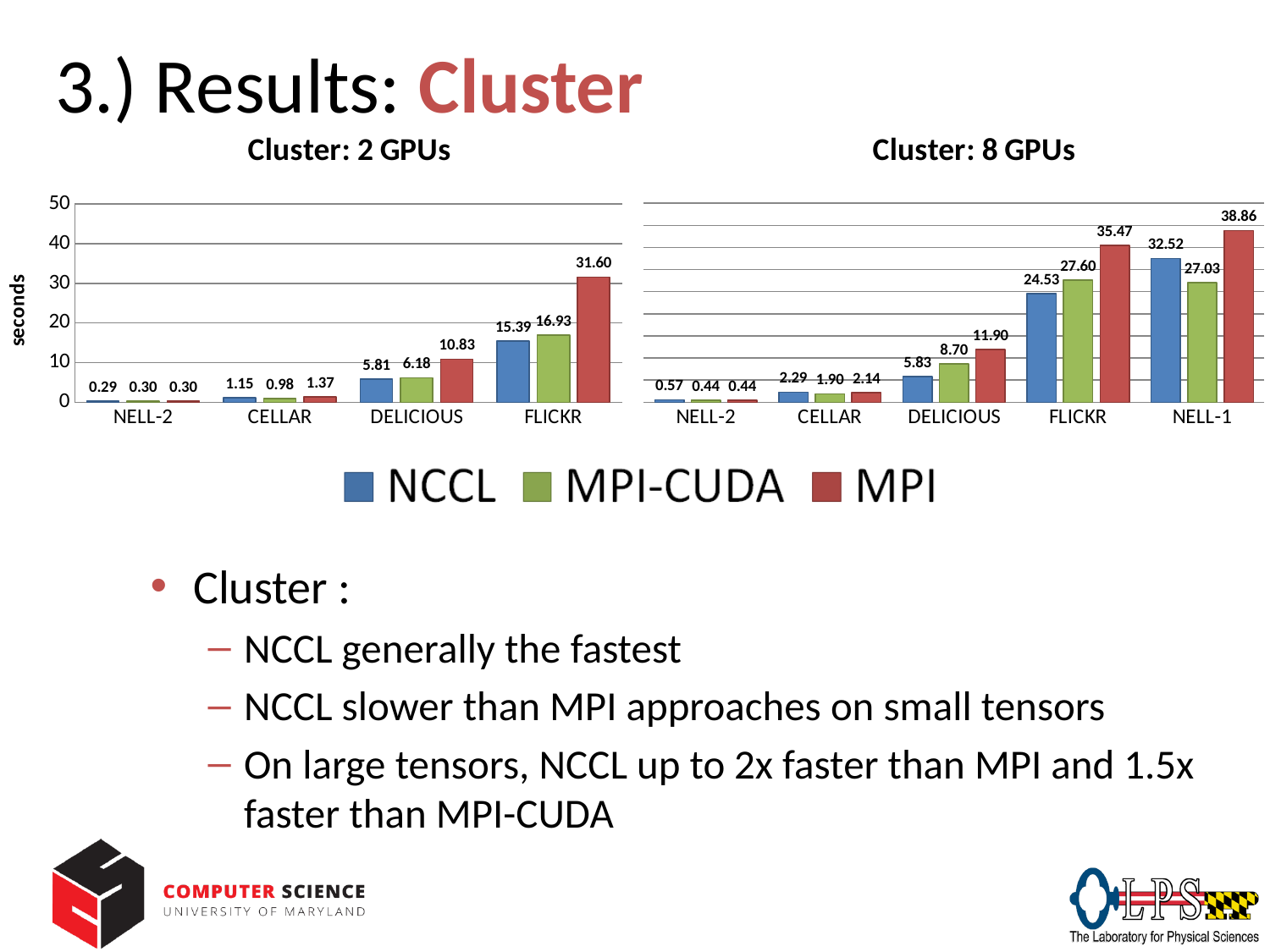
In the 'Cluster: 8 GPUs' chart, which category has the lowest NCCL value? NELL-2 In the 'Cluster: 2 GPUs' chart, what is the difference between the MPI and NCCL values for FLICKR? 16.21 In the 'Cluster: 8 GPUs' chart, what is the MPI-CUDA value for DELICIOUS? 8.70 In the 'Cluster: 2 GPUs' chart, what is the MPI value for FLICKR? 31.60 In the 'Cluster: 8 GPUs' chart, what is the difference between the MPI and MPI-CUDA values for NELL-1? 11.83 In the 'Cluster: 8 GPUs' chart, what is the NCCL value for NELL-1? 32.52 In the 'Cluster: 2 GPUs' chart, which category has the highest MPI value? FLICKR How many series does the legend list? 3 How many categories are shown on the x axis of the 'Cluster: 8 GPUs' chart? 5 What kind of chart is the 'Cluster: 2 GPUs' chart? Bar chart What is the label on the y axis of the 'Cluster: 2 GPUs' chart? seconds In the 'Cluster: 8 GPUs' chart, which is larger for FLICKR: the NCCL value or the MPI-CUDA value? MPI-CUDA